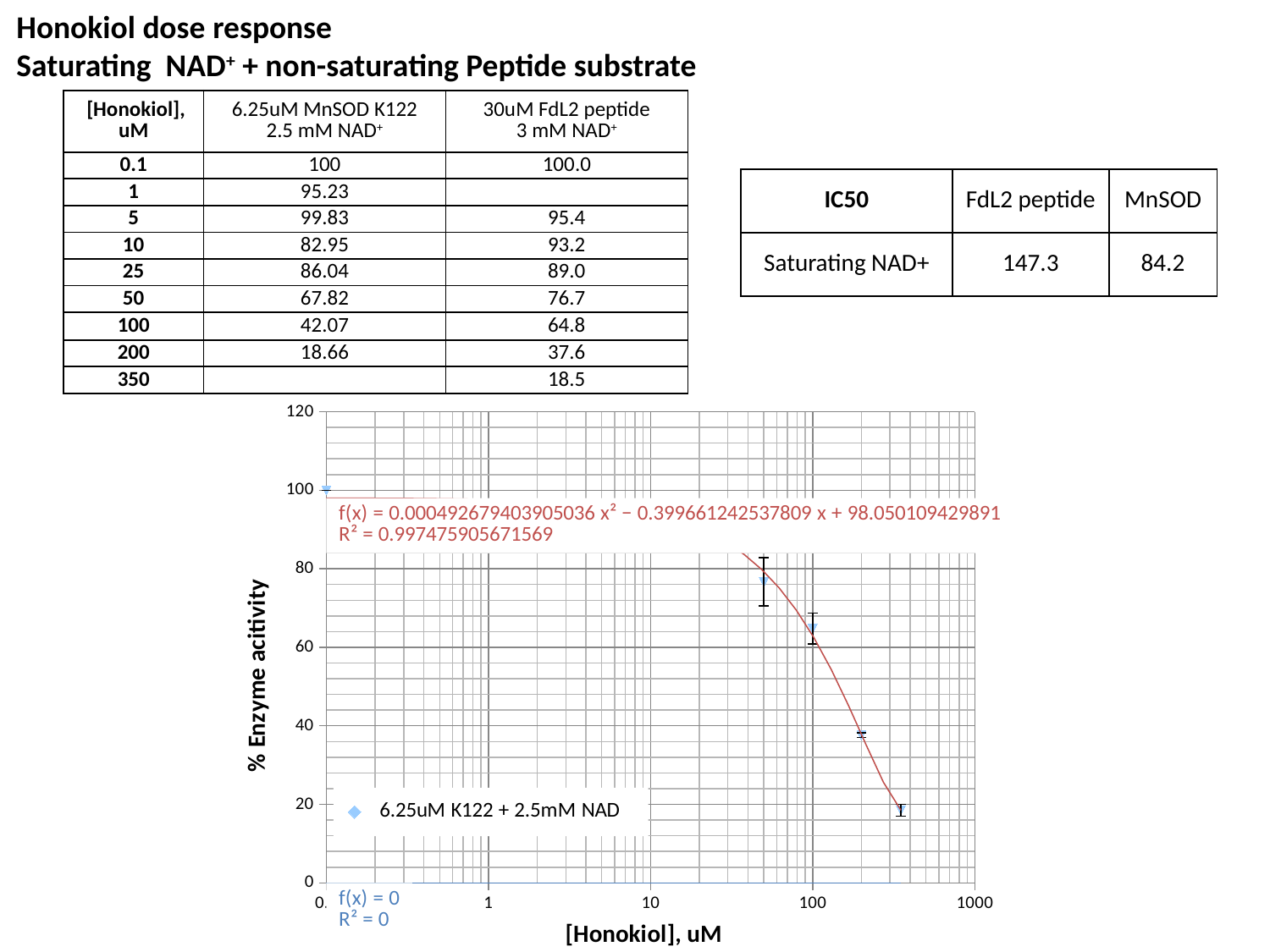
Which is larger, the plotted value at 50 uM or at 200 uM Honokiol? 50 uM Is the plotted value at 100 uM Honokiol greater or less than 60? greater Is the plotted value at 200 uM Honokiol greater or less than 40? less Which plotted point has the lowest % enzyme activity? 350 uM What is the title of the chart's y axis? % Enzyme acitivity Is the plotted value at 50 uM Honokiol greater or less than 80? less How many series does the chart legend list? 1 Do the plotted values rise or fall as [Honokiol] increases along the x axis? fall What kind of chart is shown on the slide? scatter chart What is the legend entry for the plotted series? 6.25uM K122 + 2.5mM NAD